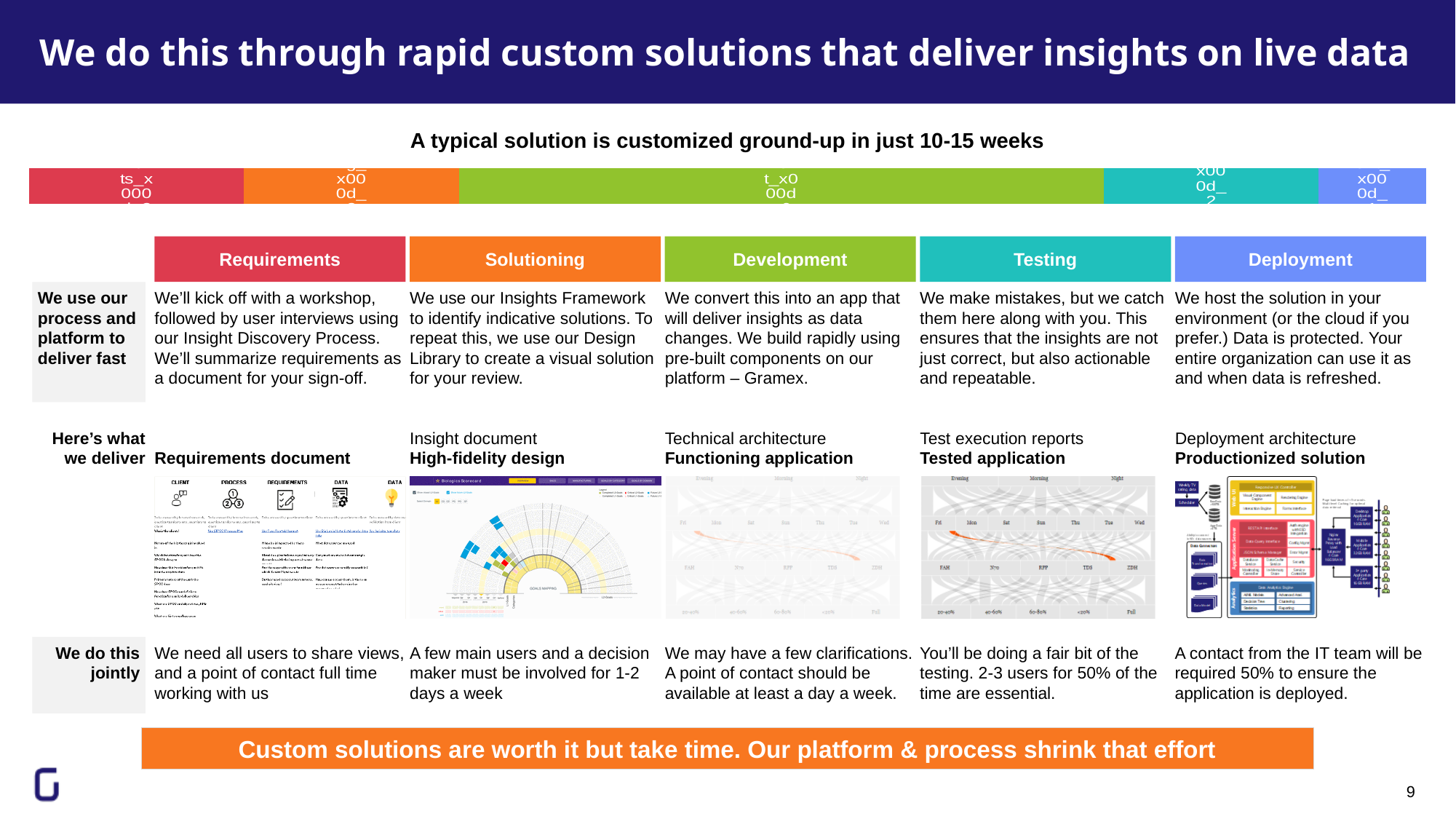
In the horizontal stacked bar near the top of the slide, which is wider: the green segment or the orange segment? The green segment What colour is the last (rightmost) segment of the horizontal stacked bar near the top of the slide? Blue Which coloured segment of the horizontal stacked bar near the top of the slide is the widest? The green segment What kind of chart is the horizontal coloured bar below the heading 'A typical solution is customized ground-up in just 10-15 weeks'? Bar chart (stacked horizontal bar) Which coloured segment of the horizontal stacked bar near the top of the slide is the narrowest? The blue segment How many coloured segments make up the horizontal stacked bar near the top of the slide? 5 What colour is the first (leftmost) segment of the horizontal stacked bar near the top of the slide? Red In the horizontal stacked bar near the top of the slide, which is wider: the teal segment or the blue segment? The teal segment